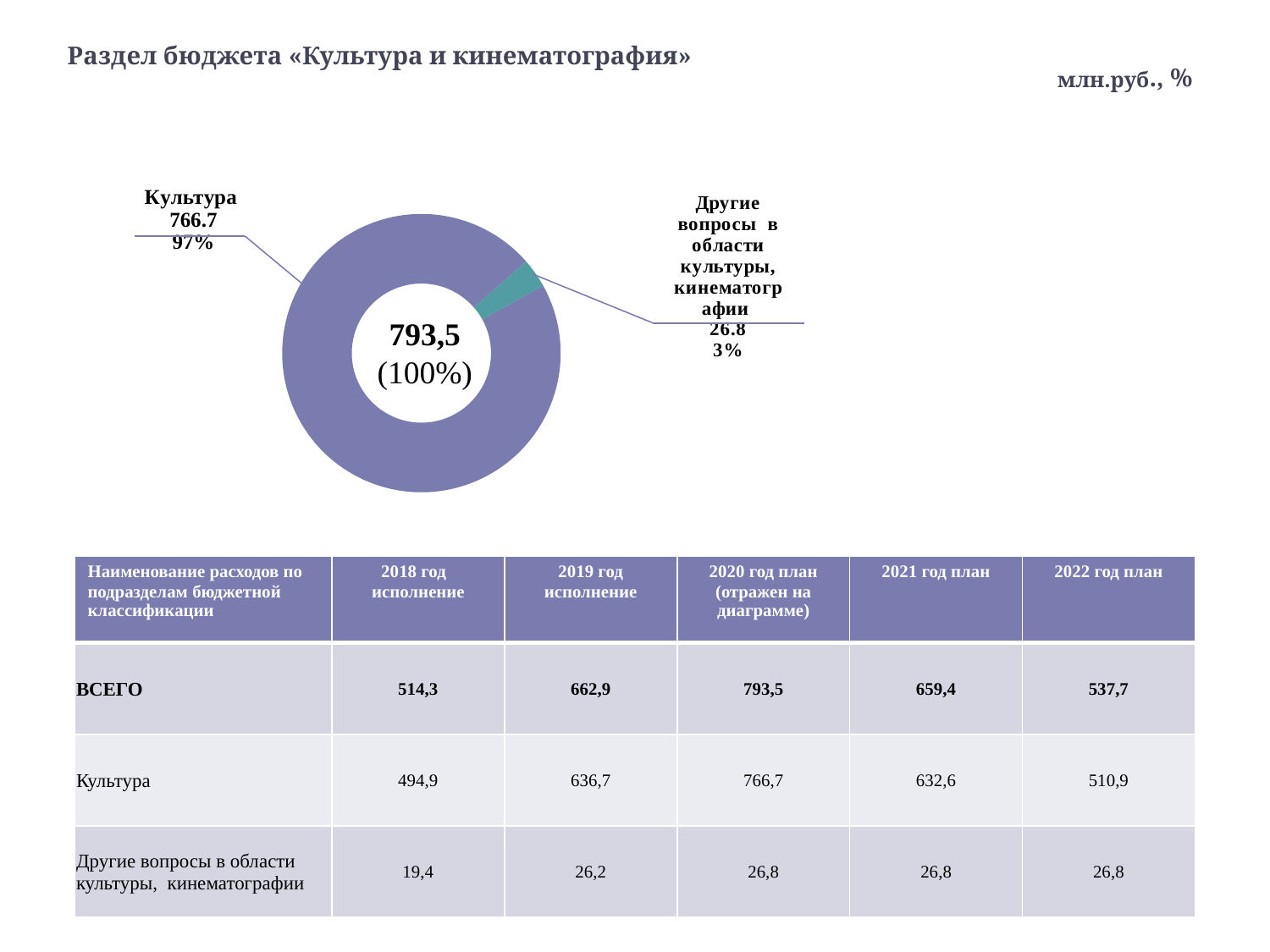
What kind of chart is shown on the slide? Donut (pie) chart What is the value shown for the Культура slice in the donut chart? 766.7 Which slice of the donut chart is the smallest? Другие вопросы в области культуры, кинематографии What total value is shown in the centre of the donut chart? 793,5 (100%) What is the value shown for the slice 'Другие вопросы в области культуры, кинематографии' in the donut chart? 26.8 What percentage share does the slice 'Другие вопросы в области культуры, кинематографии' have in the donut chart? 3% What percentage share does the Культура slice have in the donut chart? 97% Which slice of the donut chart is the largest? Культура How many slices does the donut chart have? 2 Which is larger in the donut chart: Культура or Другие вопросы в области культуры, кинематографии? Культура What is the difference between the Культура value and the 'Другие вопросы в области культуры, кинематографии' value in the donut chart? 739.9 What units are indicated in the top right corner of the slide for the chart? млн.руб., %